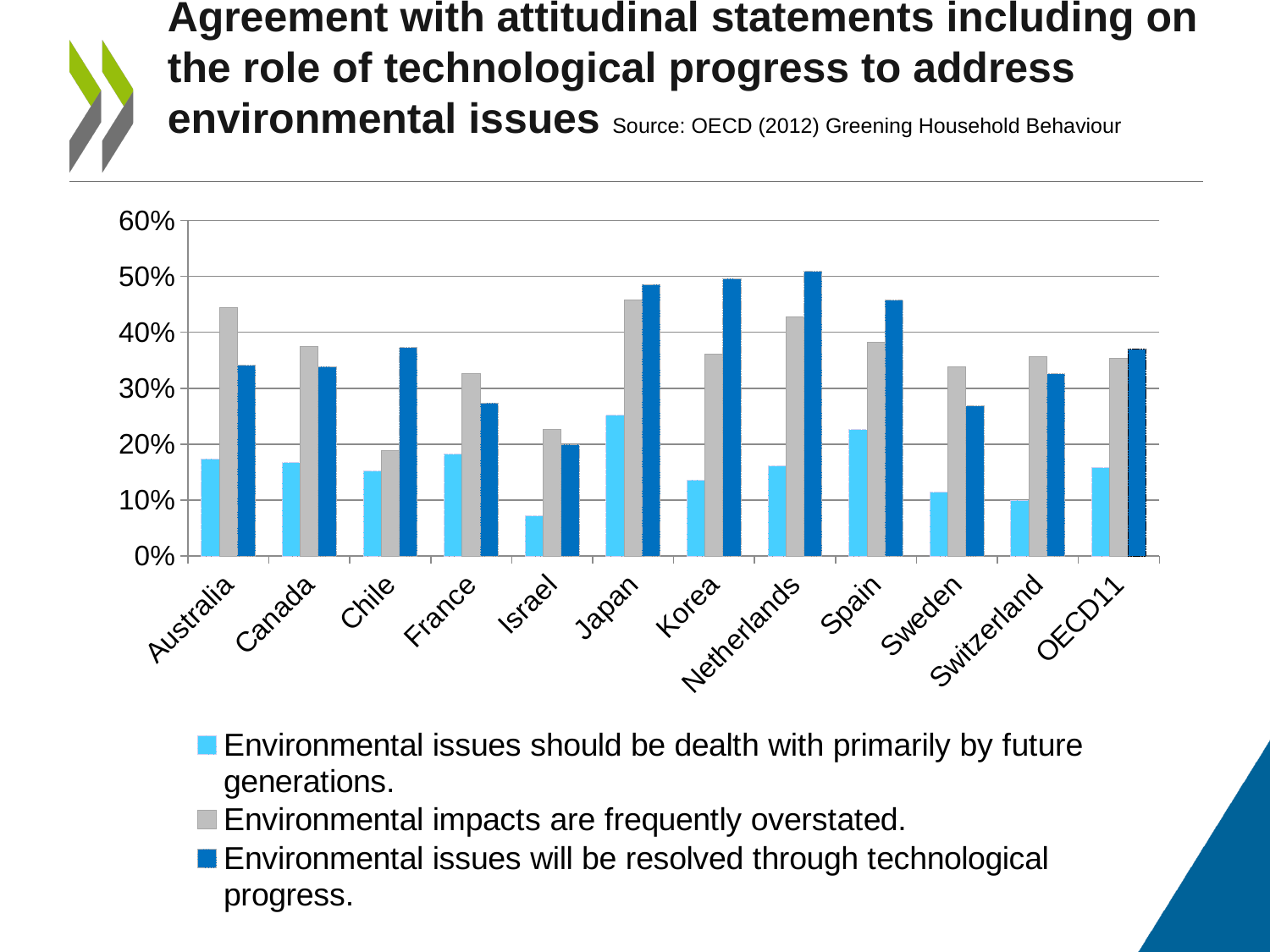
What is the source cited for the chart? OECD (2012) Greening Household Behaviour What kind of chart is shown on the slide? bar chart Which has the larger value for 'Environmental issues will be resolved through technological progress': Korea or Sweden? Korea Which country has the lowest value for 'Environmental issues should be dealth with primarily by future generations'? Israel How many countries or groups are shown along the x axis? 12 Is the value for Israel on 'Environmental issues should be dealth with primarily by future generations' greater or less than 10%? less Which country has the lowest value for 'Environmental issues will be resolved through technological progress'? Israel Which country has the highest value for 'Environmental issues should be dealth with primarily by future generations'? Japan How many series does the legend list? 3 Is the value for Australia on 'Environmental impacts are frequently overstated' greater or less than 40%? greater For Chile, which is larger: 'Environmental impacts are frequently overstated' or 'Environmental issues will be resolved through technological progress'? Environmental issues will be resolved through technological progress Is the value for Sweden on 'Environmental issues will be resolved through technological progress' greater or less than 30%? less